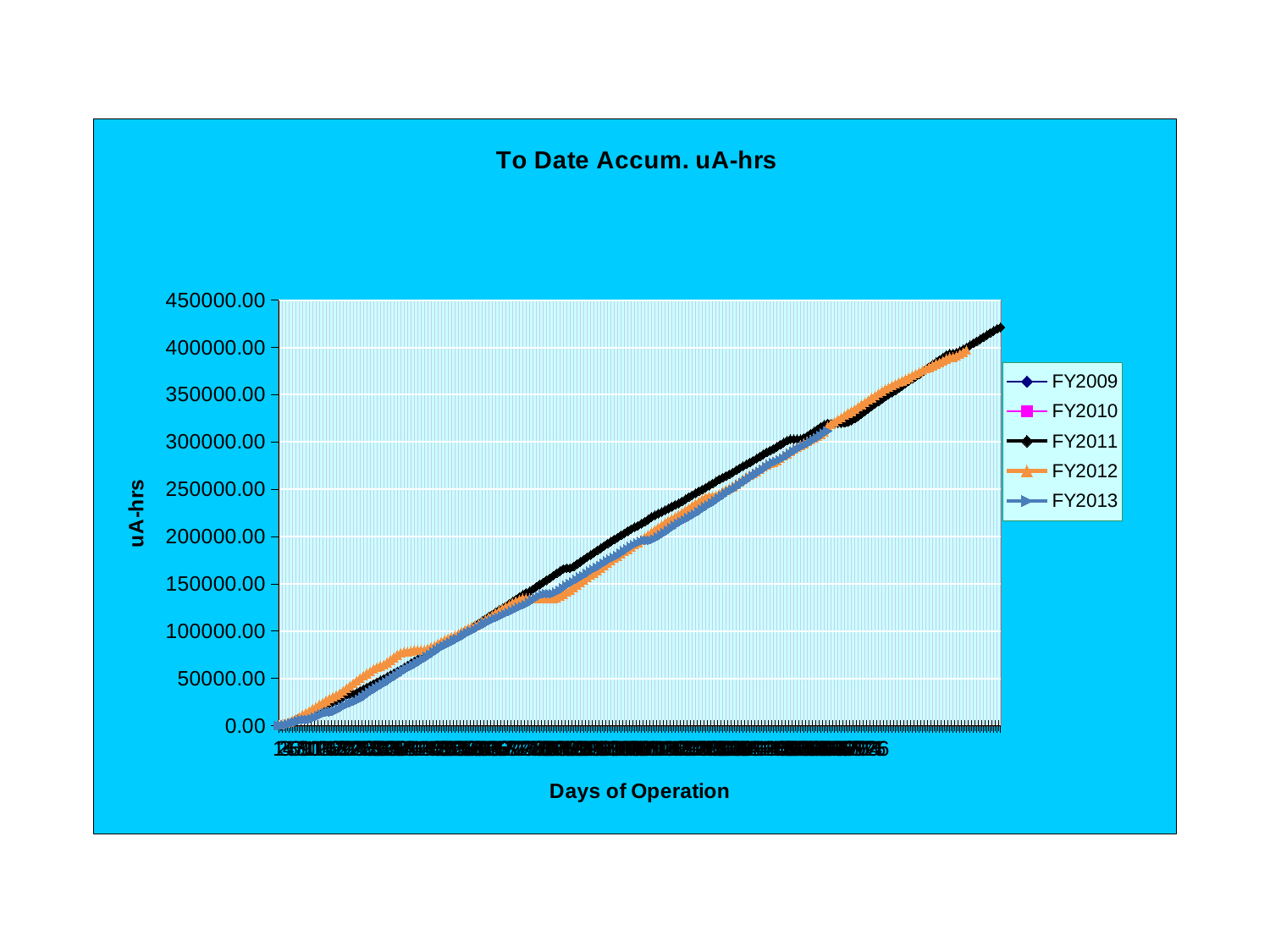
Is the highest value reached by the FY2013 series greater or less than 350000.00? less Which series reaches a higher final value, FY2011 or FY2013? FY2011 What is the label of the x axis? Days of Operation What is the title of the chart? To Date Accum. uA-hrs Do the plotted values rise or fall as the days of operation increase? rise Which series reaches the highest accumulated uA-hrs value on the chart? FY2011 What kind of chart is shown on the slide? line chart Is the highest value reached by the FY2011 series greater or less than 400000.00? greater What is the highest tick value shown on the y axis? 450000.00 Is the highest value reached by the FY2012 series greater or less than 350000.00? greater How many series does the legend list? 5